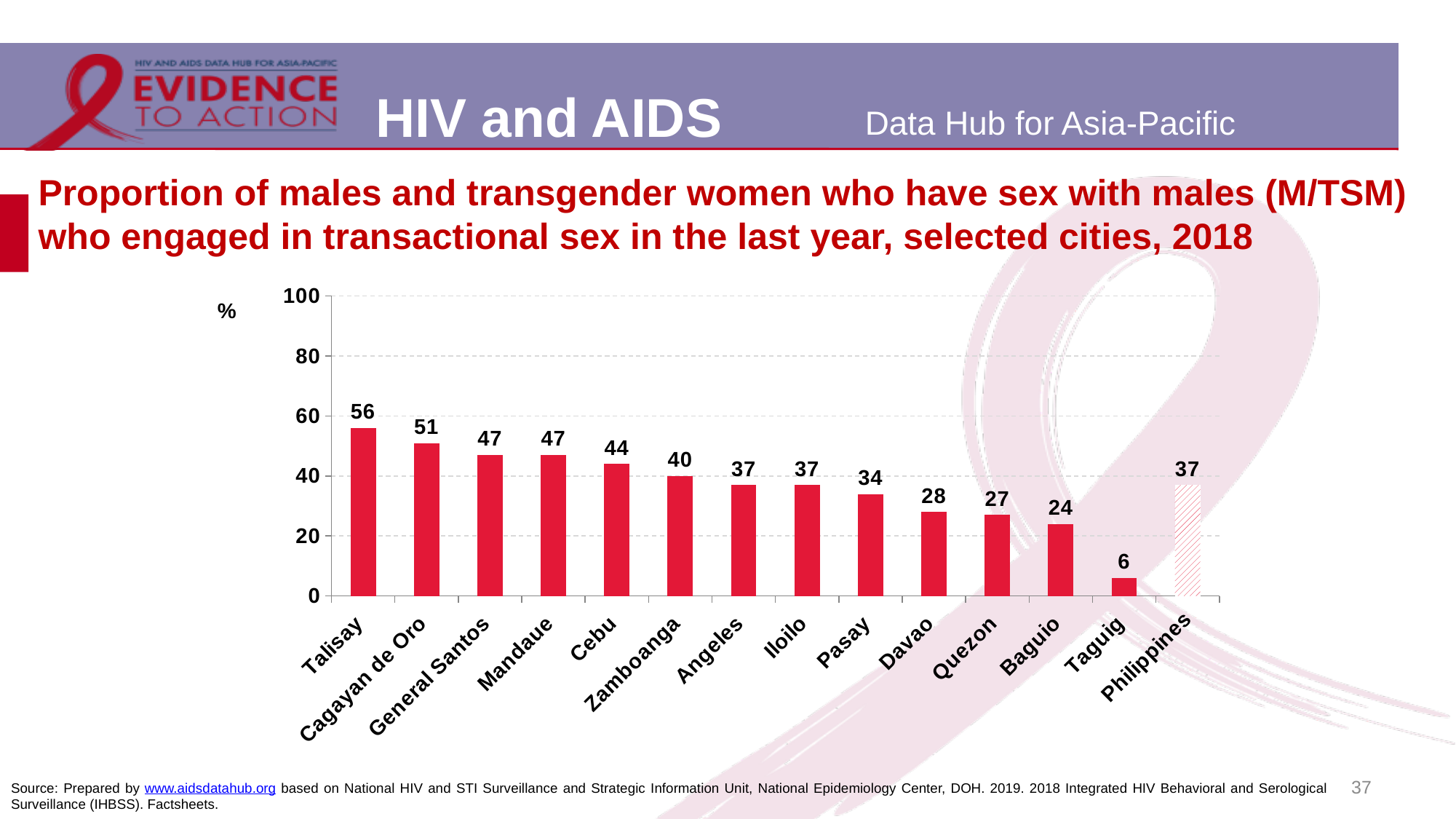
What unit is shown on the y axis label? % What is the value for Philippines? 37 Which is larger, the value for Pasay or the value for Davao? Pasay Which city has the highest value? Talisay What is the value for Talisay? 56 How many categories are shown on the x axis? 14 What kind of chart is shown on the slide? bar chart Is the value for Baguio greater or less than 20? greater Which city has the lowest value? Taguig What is the difference between the values for Talisay and Taguig? 50 What is the difference between the values for Cagayan de Oro and Cebu? 7 What is the value for Zamboanga? 40